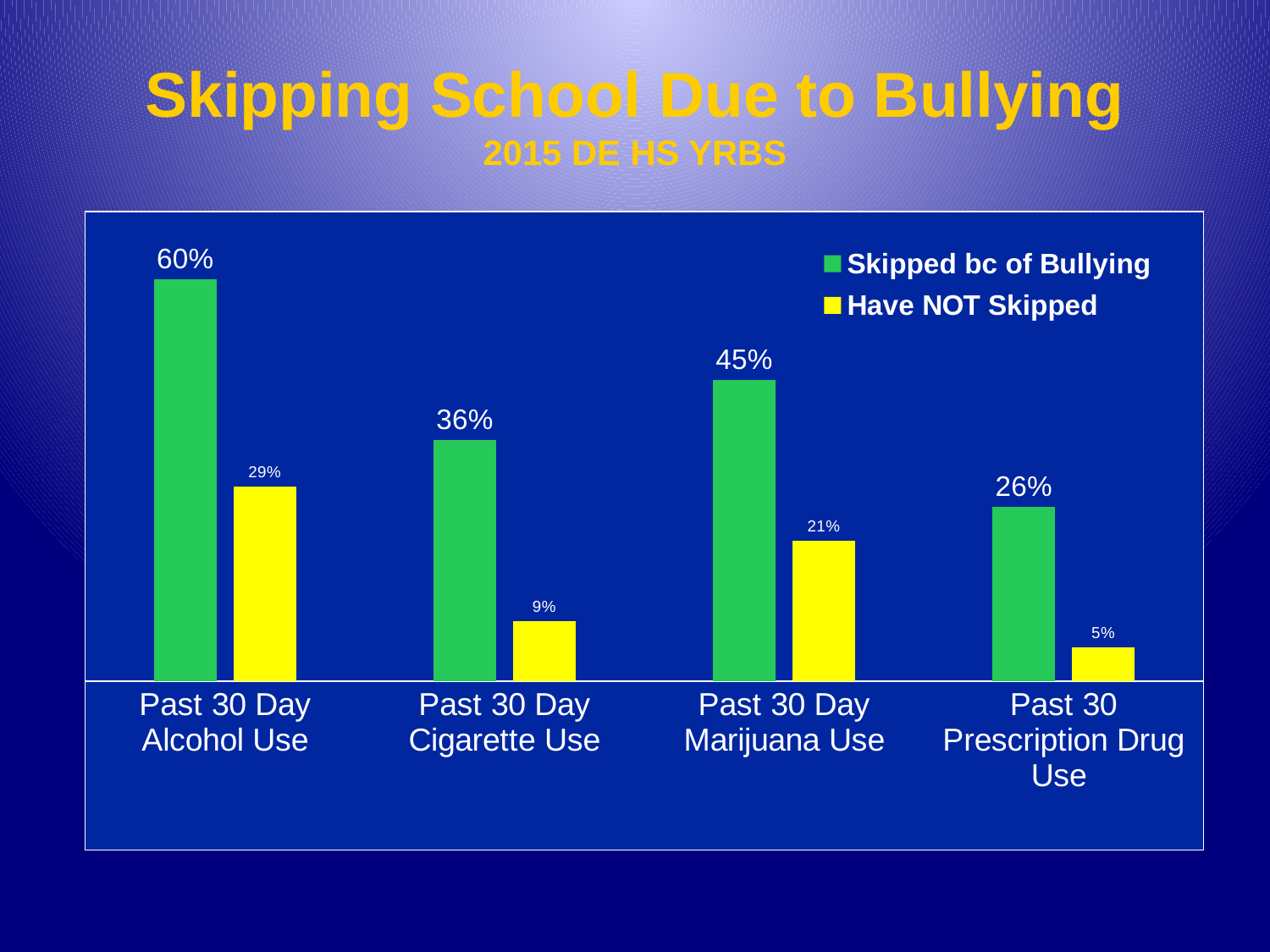
What is the difference between Skipped bc of Bullying and Have NOT Skipped for Past 30 Day Cigarette Use? 27% Which category has the lowest value for Have NOT Skipped? Past 30 Prescription Drug Use How many categories are shown on the x axis? 4 What kind of chart is shown on the slide? Bar chart What is the value for Have NOT Skipped for Past 30 Prescription Drug Use? 5% What is the title of the slide? Skipping School Due to Bullying What is the value for Have NOT Skipped for Past 30 Day Marijuana Use? 21% Which is larger for Past 30 Day Marijuana Use: Skipped bc of Bullying or Have NOT Skipped? Skipped bc of Bullying How many series does the legend list? 2 What colour are the bars for the Have NOT Skipped series? Yellow Which category has the highest value for Skipped bc of Bullying? Past 30 Day Alcohol Use What is the value for Skipped bc of Bullying for Past 30 Day Alcohol Use? 60%